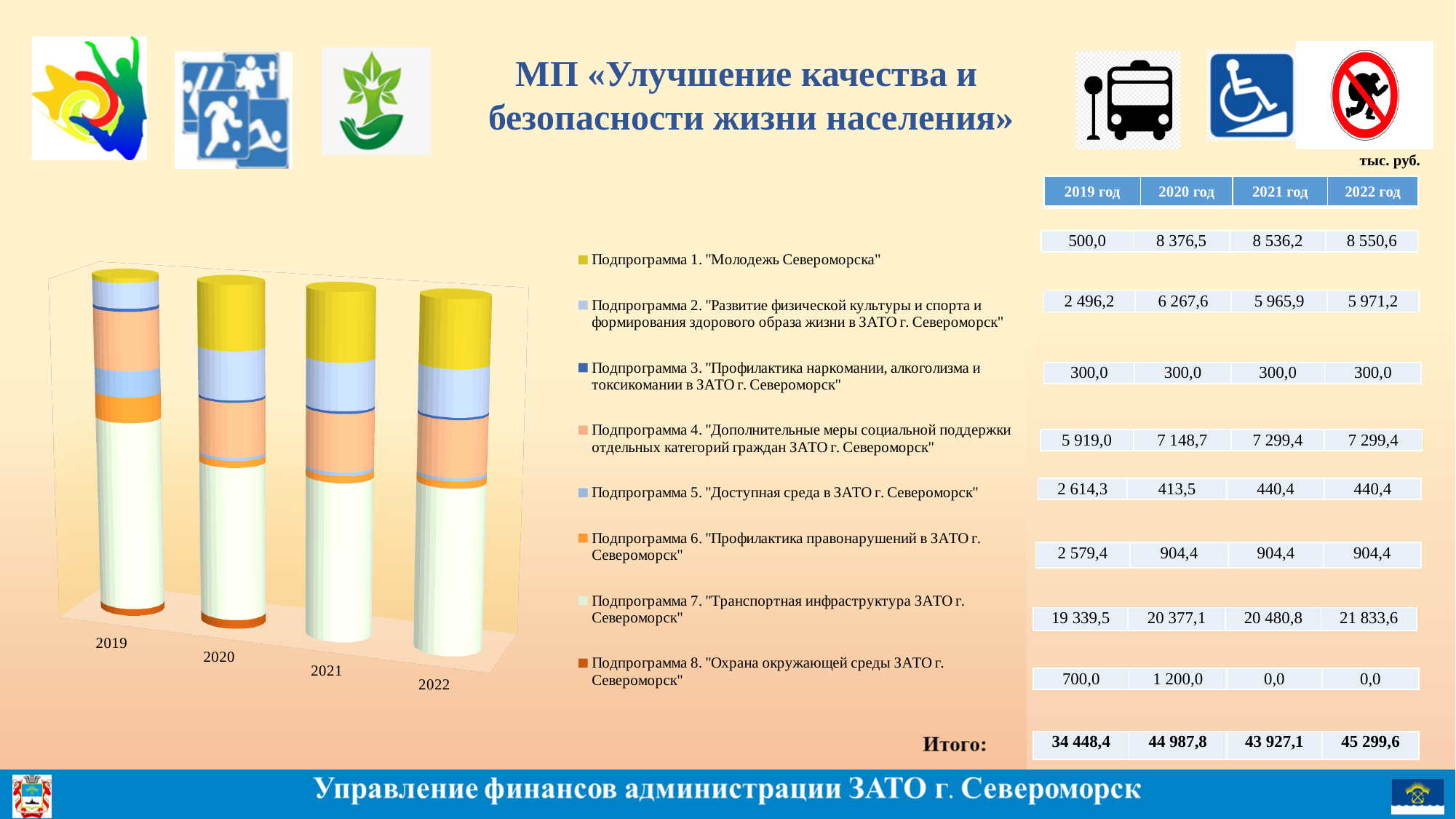
What is the total (Итого) for 2022 год? 45 299,6 What is the value for Подпрограмма 8 "Охрана окружающей среды ЗАТО г. Североморск" in 2021 год? 0,0 How many subprograms (series) does the legend list? 8 Which year has the lowest total (Итого)? 2019 год What kind of chart is shown on the slide? Stacked bar chart Does the value for Подпрограмма 7 "Транспортная инфраструктура ЗАТО г. Североморск" rise or fall from 2019 to 2022? Rise What is the value for Подпрограмма 7 "Транспортная инфраструктура ЗАТО г. Североморск" in 2022 год? 21 833,6 Which year has the highest total (Итого)? 2022 год By how much does the value for Подпрограмма 1 "Молодежь Североморска" in 2020 год exceed its value in 2019 год? 7 876,5 What colour represents Подпрограмма 1 "Молодежь Североморска" in the chart legend? Yellow Which is larger for Подпрограмма 5 "Доступная среда в ЗАТО г. Североморск": the value in 2019 год or in 2020 год? 2019 год How many years (categories) are shown on the x axis of the chart? 4